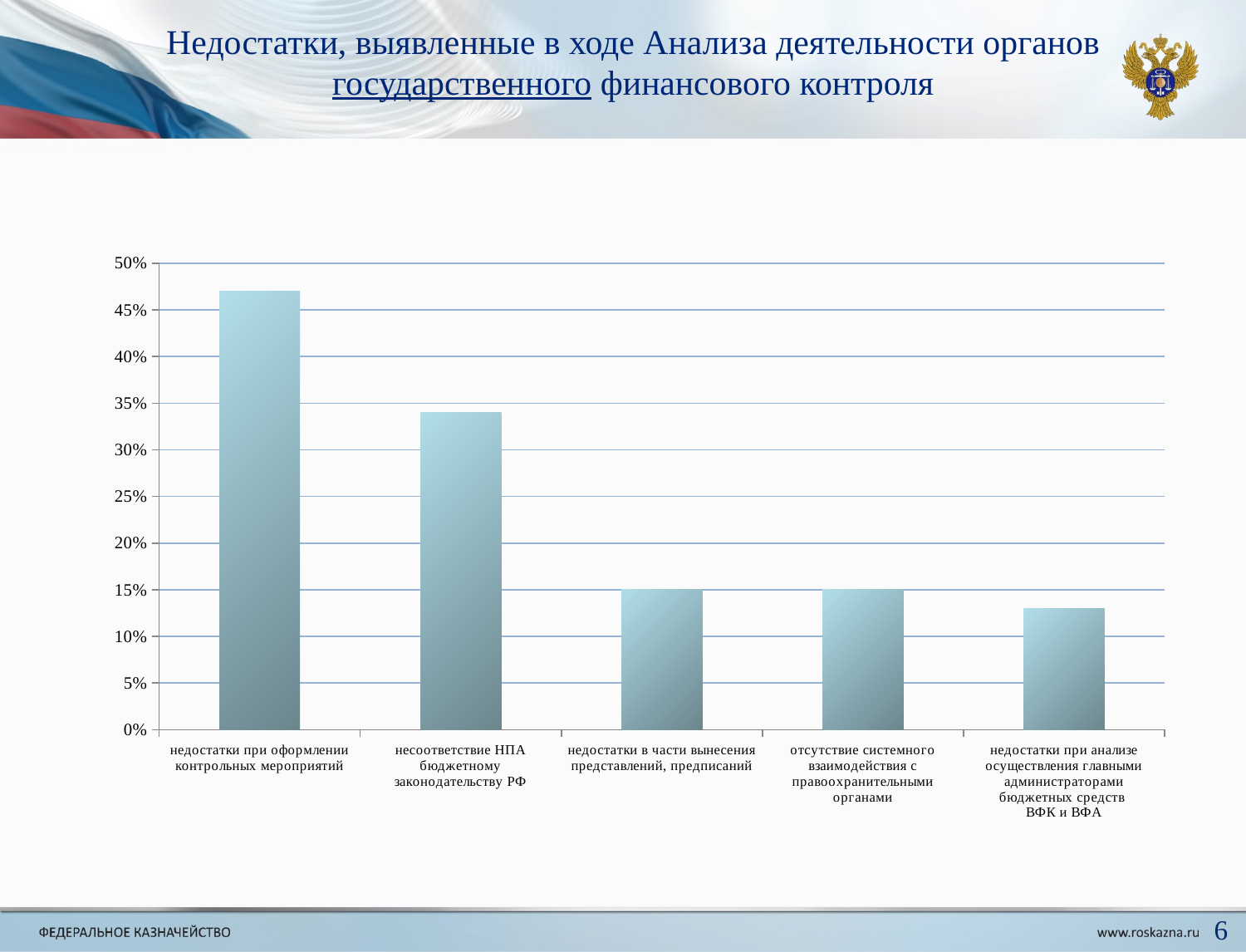
Is the value for 'несоответствие НПА бюджетному законодательству РФ' greater or less than 35%? less What is the value for 'отсутствие системного взаимодействия с правоохранительными органами'? 15% Is the value for 'недостатки при оформлении контрольных мероприятий' greater or less than 45%? greater Do the values generally rise or fall from left to right along the x axis? fall How many categories are shown on the x axis of the chart? 5 What is the value for 'недостатки в части вынесения представлений, предписаний'? 15% Is the value for 'недостатки при анализе осуществления главными администраторами бюджетных средств ВФК и ВФА' greater or less than 15%? less What is the maximum value shown on the vertical axis of the chart? 50% What kind of chart is shown on the slide? bar chart Which is larger: the value for 'недостатки при оформлении контрольных мероприятий' or the value for 'несоответствие НПА бюджетному законодательству РФ'? недостатки при оформлении контрольных мероприятий Which category has the highest value in the chart? недостатки при оформлении контрольных мероприятий Which category has the lowest value in the chart? недостатки при анализе осуществления главными администраторами бюджетных средств ВФК и ВФА